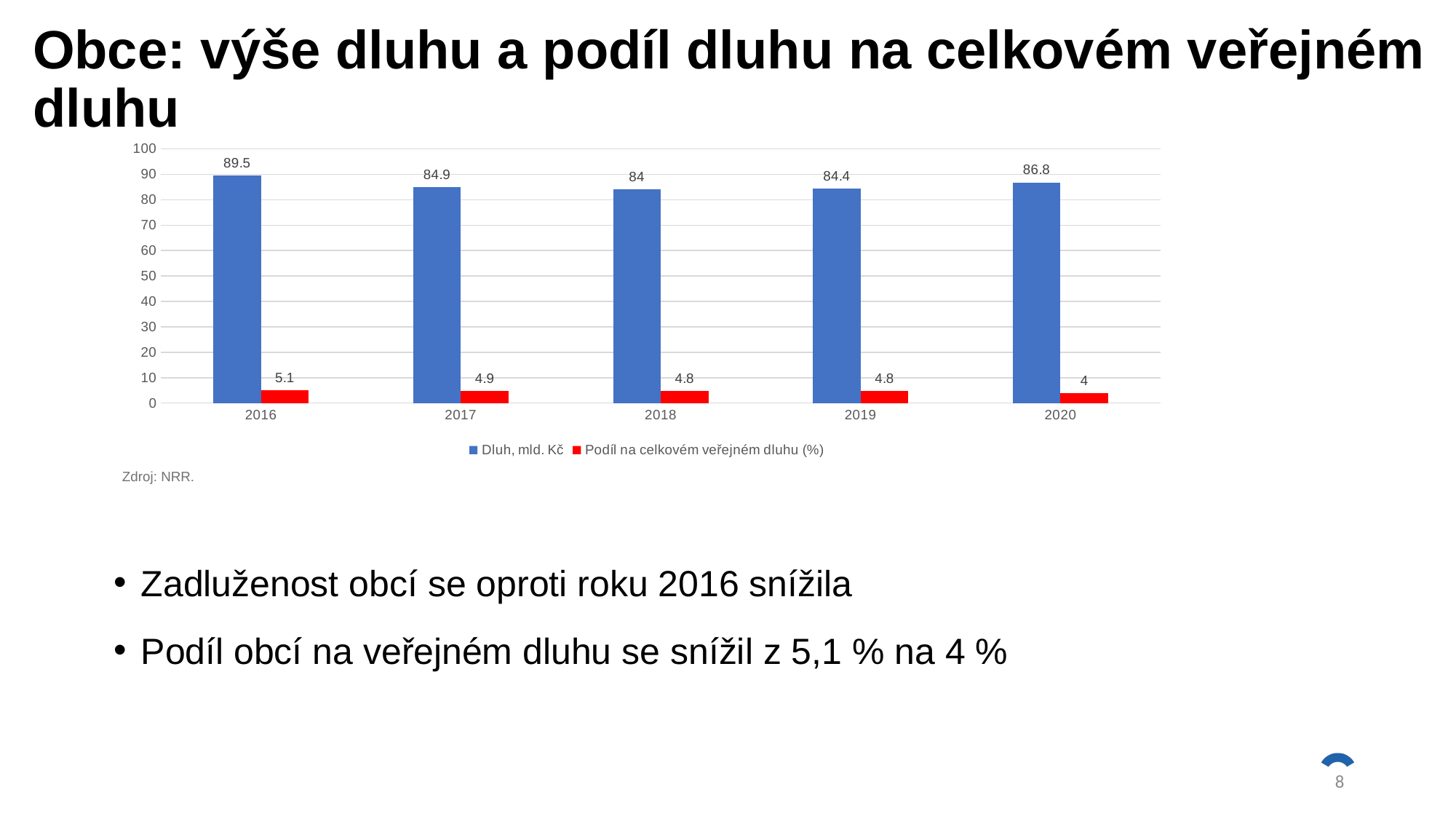
Which year has the highest value for "Dluh, mld. Kč"? 2016 What colour are the bars for "Podíl na celkovém veřejném dluhu (%)"? Red What is the difference between the "Dluh, mld. Kč" values for 2016 and 2020? 2.7 How many series does the legend list? 2 What is the value of "Podíl na celkovém veřejném dluhu (%)" for 2020? 4 What is the value of "Dluh, mld. Kč" for 2018? 84 How many years are shown on the x axis? 5 What is the value of "Dluh, mld. Kč" for 2016? 89.5 Which year has the lowest value for "Dluh, mld. Kč"? 2018 What kind of chart is shown on the slide? Bar chart Which year has the lowest value for "Podíl na celkovém veřejném dluhu (%)"? 2020 Is the "Dluh, mld. Kč" value for 2017 larger than the value for 2020? No